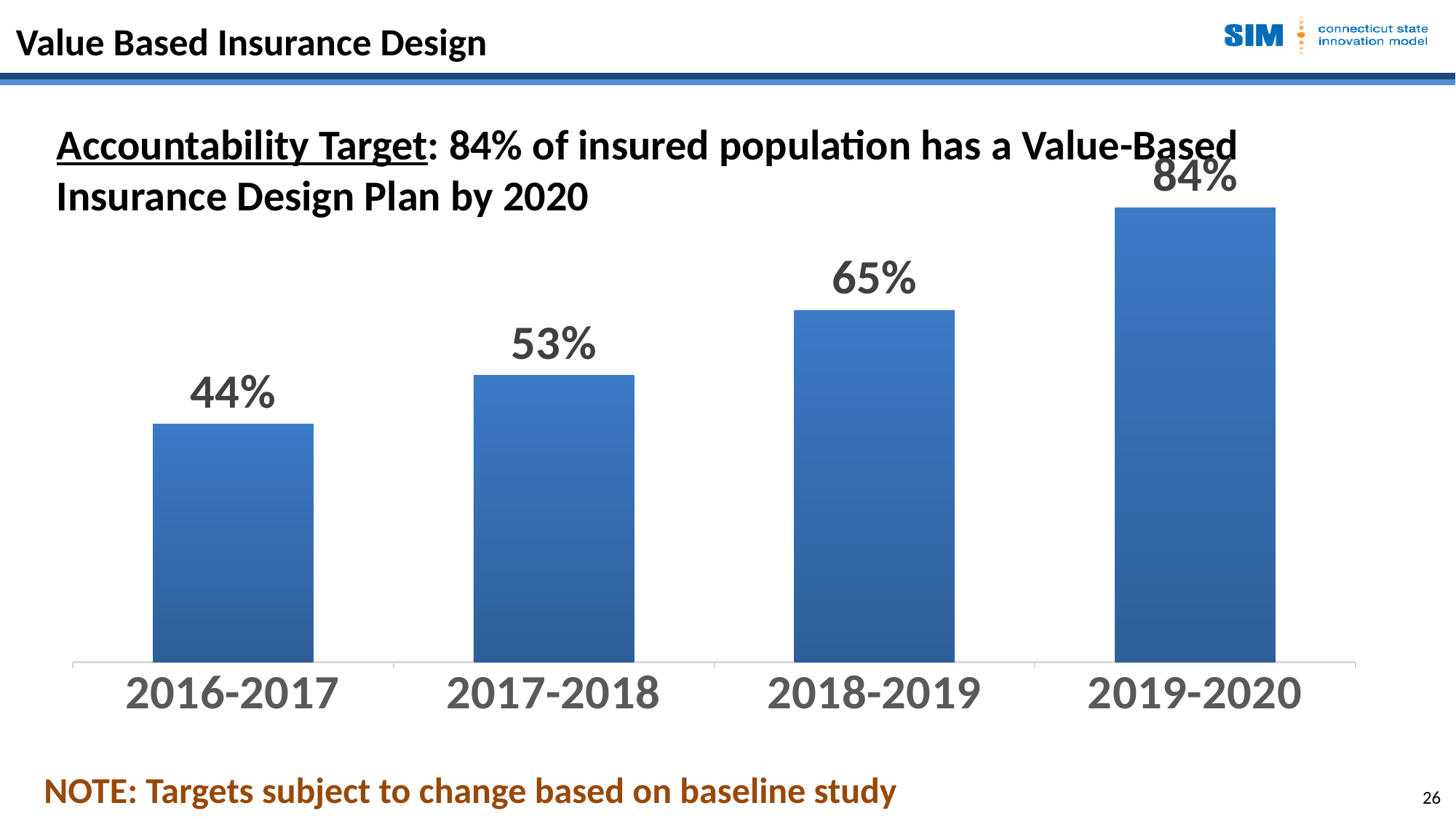
Which period has the lowest value? 2016-2017 What is the value for 2018-2019? 65% What is the value for 2019-2020? 84% What kind of chart is shown on the slide? bar chart How many periods are shown on the x axis? 4 What is the value for 2017-2018? 53% What is the value for 2016-2017? 44% Do the values rise or fall from 2016-2017 to 2019-2020? rise Which is larger, the value for 2017-2018 or the value for 2018-2019? 2018-2019 What is the difference between the values for 2019-2020 and 2016-2017? 40% Which period has the highest value? 2019-2020 What is the difference between the values for 2018-2019 and 2017-2018? 12%